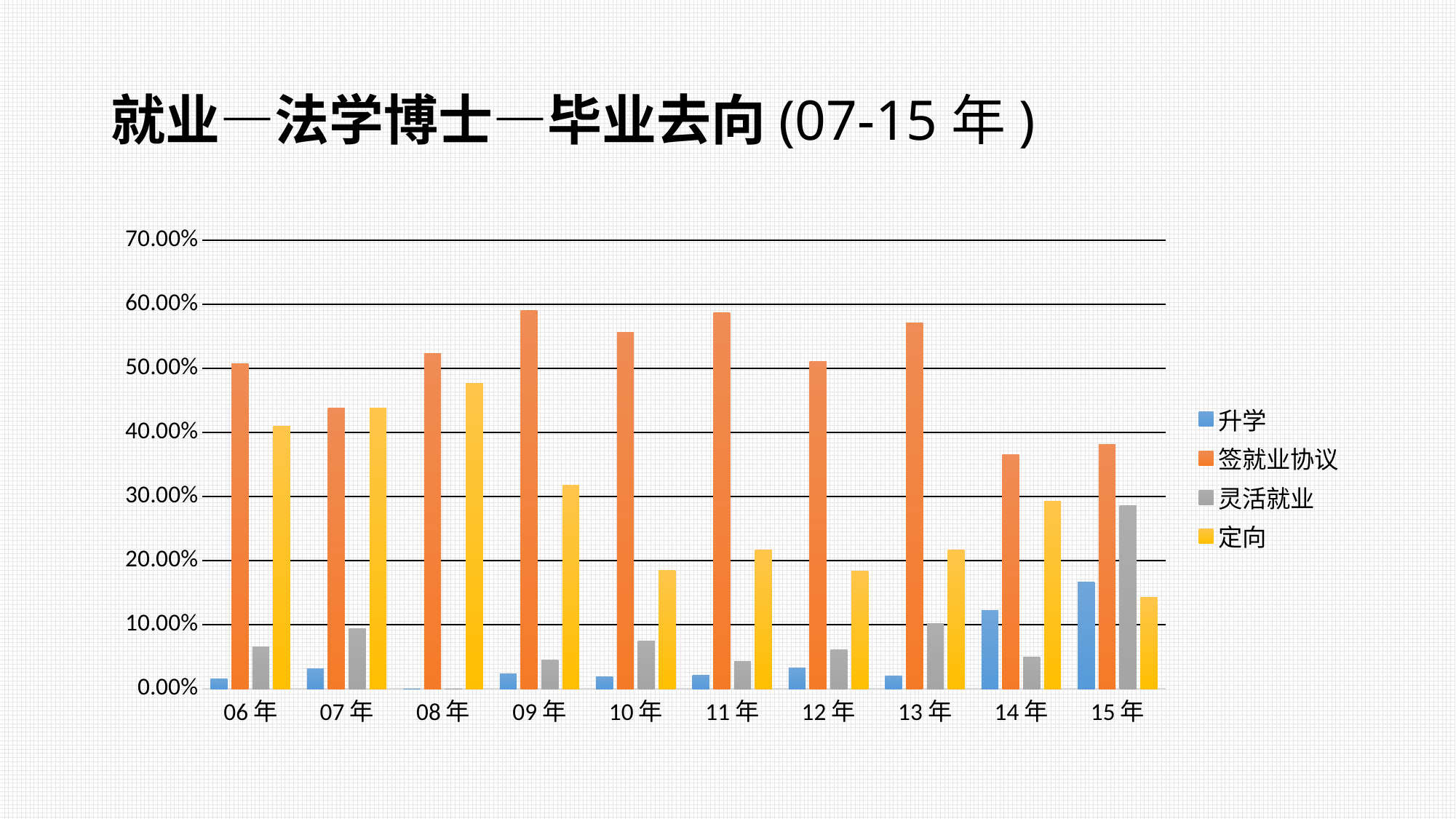
What kind of chart is shown on the slide? bar chart Is the value for 签就业协议 in 14 年 greater or less than 40.00%? less In which year is the value for 升学 the lowest? 08 年 In which year is the value for 定向 the highest? 08 年 Which year has the larger value for 灵活就业, 13 年 or 14 年? 13 年 Is the value for 升学 in 14 年 greater or less than 10.00%? greater Does the value for 升学 rise or fall from 13 年 to 15 年? rise In which year is the value for 灵活就业 the highest? 15 年 Is the value for 签就业协议 in 09 年 greater or less than 50.00%? greater How many series does the legend list? 4 How many year categories are shown on the x axis? 10 In which year is the value for 定向 the lowest? 15 年